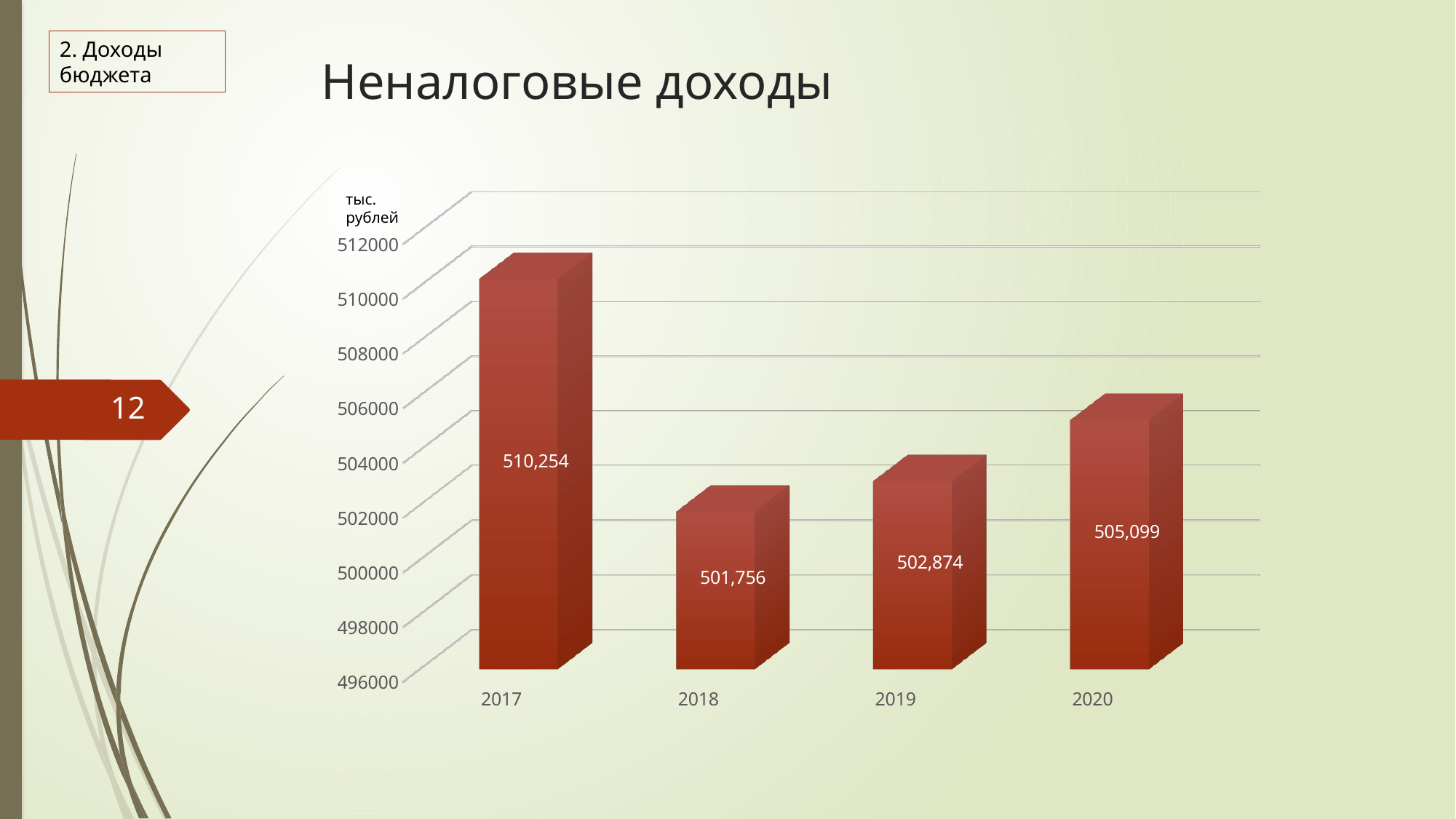
What is the difference between the values for 2020 and 2019? 2,225 What is the title of the chart? Неналоговые доходы Which year has the highest value? 2017 What is the value for 2020? 505,099 Which is larger, the value for 2019 or the value for 2020? 2020 What kind of chart is shown on the slide? bar chart What is the difference between the values for 2017 and 2018? 8,498 How many years are shown on the x axis? 4 What is the value for 2017? 510,254 Which year has the lowest value? 2018 What is the value for 2019? 502,874 What is the value for 2018? 501,756